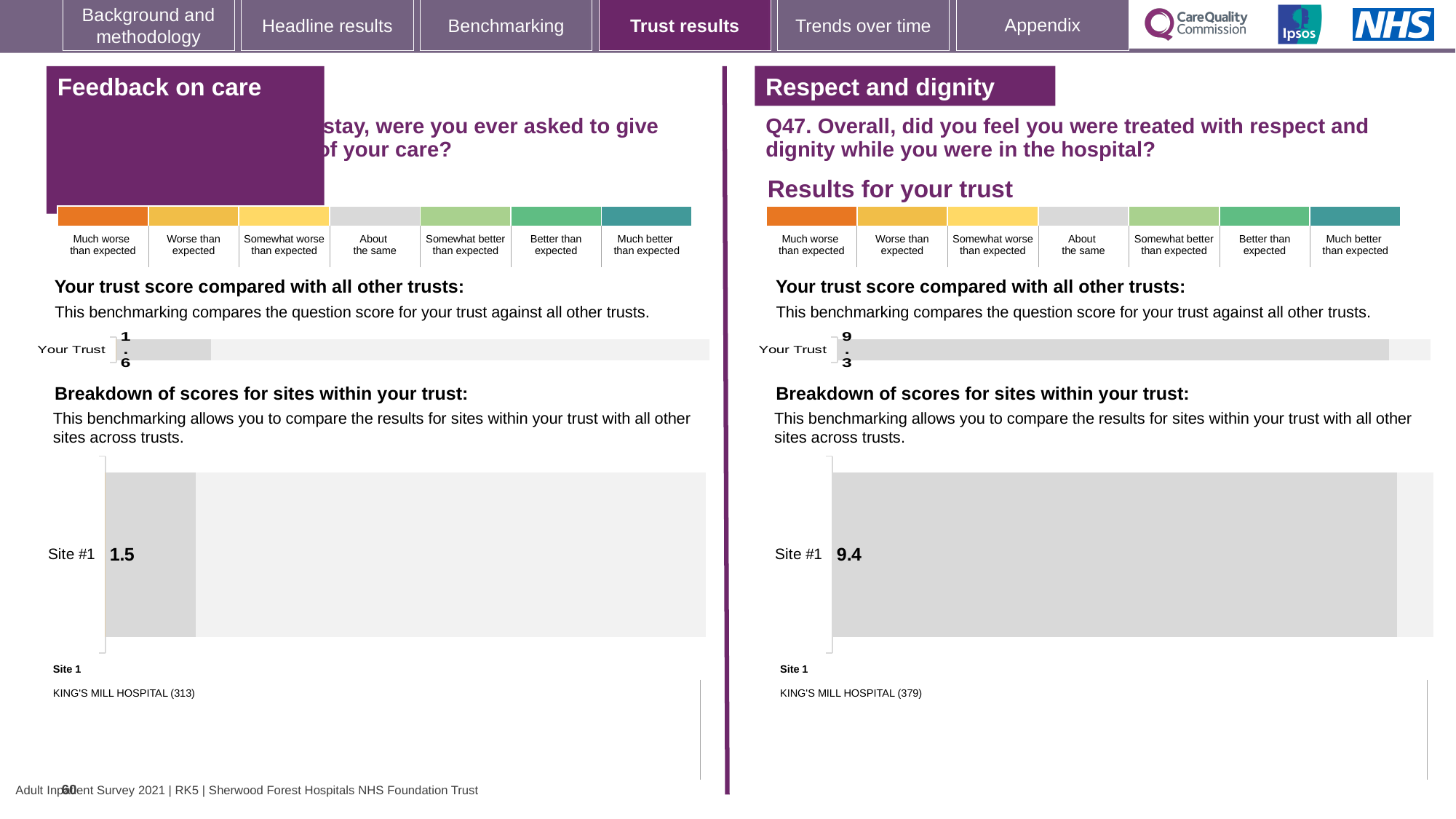
In the Respect and dignity section, what is the score shown for Site #1 in the breakdown of scores for sites chart? 9.4 In the Feedback on care section, which is larger: the Your Trust score or the Site #1 score? Your Trust Which is larger: the Site #1 score in the Feedback on care section or the Site #1 score in the Respect and dignity section? Respect and dignity In the Feedback on care section, what is the score shown for Site #1 in the breakdown of scores for sites chart? 1.5 In the Respect and dignity section, what is the score shown for Your Trust in the 'Your trust score compared with all other trusts' chart? 9.3 Which site is listed as Site 1 in the Feedback on care section? KING'S MILL HOSPITAL (313) How many sites are shown in the breakdown of scores chart in the Respect and dignity section? 1 What type of chart is used to show the Site #1 score in the Feedback on care section? Bar chart What is the difference between the Site #1 score in the Respect and dignity section and the Site #1 score in the Feedback on care section? 7.9 In the Feedback on care section, what is the score shown for Your Trust in the 'Your trust score compared with all other trusts' chart? 1.6 Which site is listed as Site 1 in the Respect and dignity section? KING'S MILL HOSPITAL (379) In the Respect and dignity section, what is the difference between the Site #1 score and the Your Trust score? 0.1